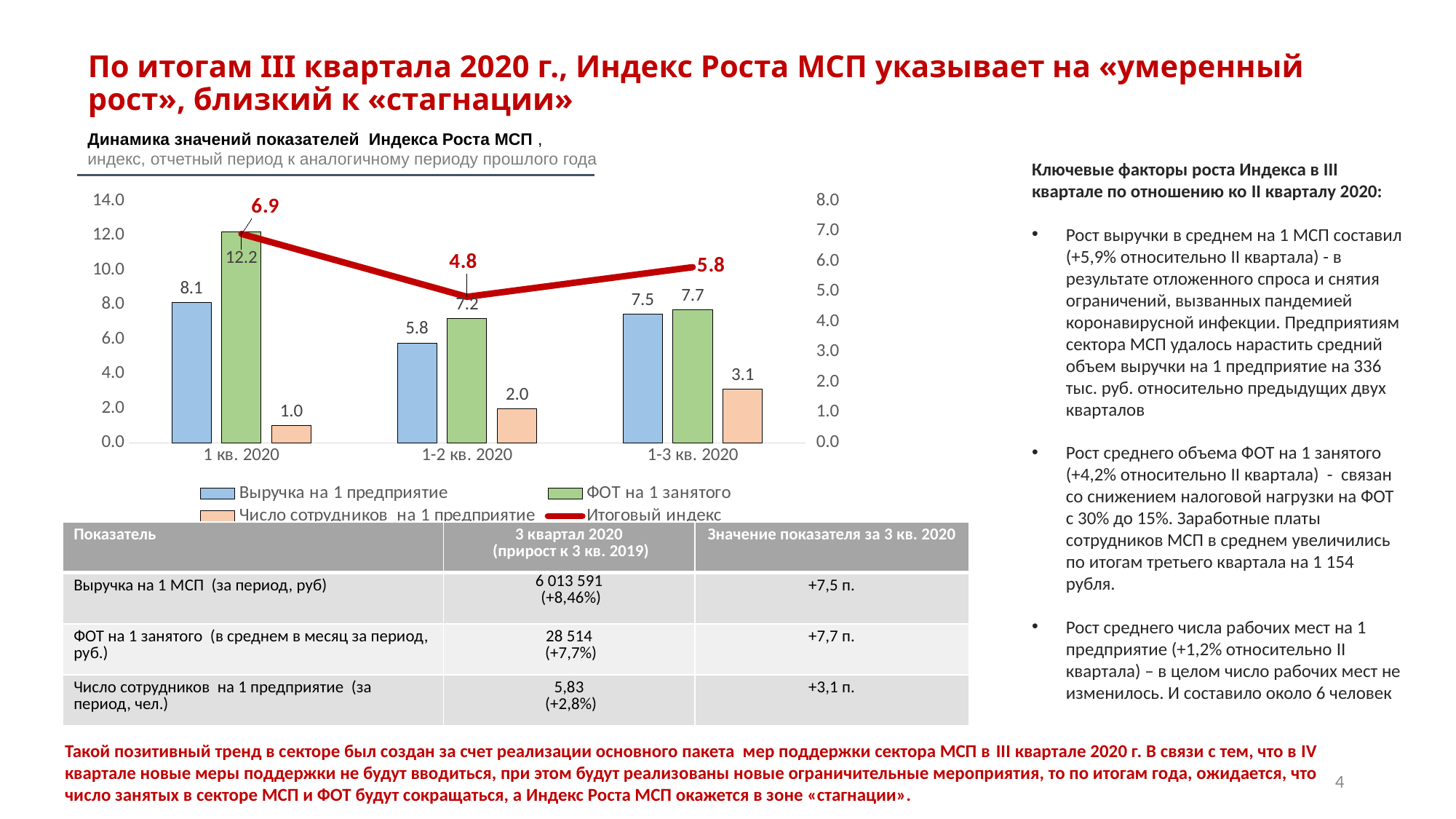
What is the value of "Выручка на 1 предприятие" for "1 кв. 2020"? 8.1 What is the value of "ФОТ на 1 занятого" for "1-2 кв. 2020"? 7.2 Which is larger for "1-3 кв. 2020": "Выручка на 1 предприятие" or "Число сотрудников на 1 предприятие"? Выручка на 1 предприятие Does "Число сотрудников на 1 предприятие" rise or fall across the periods from "1 кв. 2020" to "1-3 кв. 2020"? Rise What is the difference between "ФОТ на 1 занятого" in "1 кв. 2020" and in "1-2 кв. 2020"? 5.0 In which period is "Итоговый индекс" lowest? 1-2 кв. 2020 How many series does the chart legend list? 4 What kind of chart is shown on the slide? Combined bar and line chart What is the value of "Число сотрудников на 1 предприятие" for "1-3 кв. 2020"? 3.1 In which period is "ФОТ на 1 занятого" highest? 1 кв. 2020 How many periods are shown on the x axis of the chart? 3 What is the value of "Итоговый индекс" for "1-3 кв. 2020"? 5.8